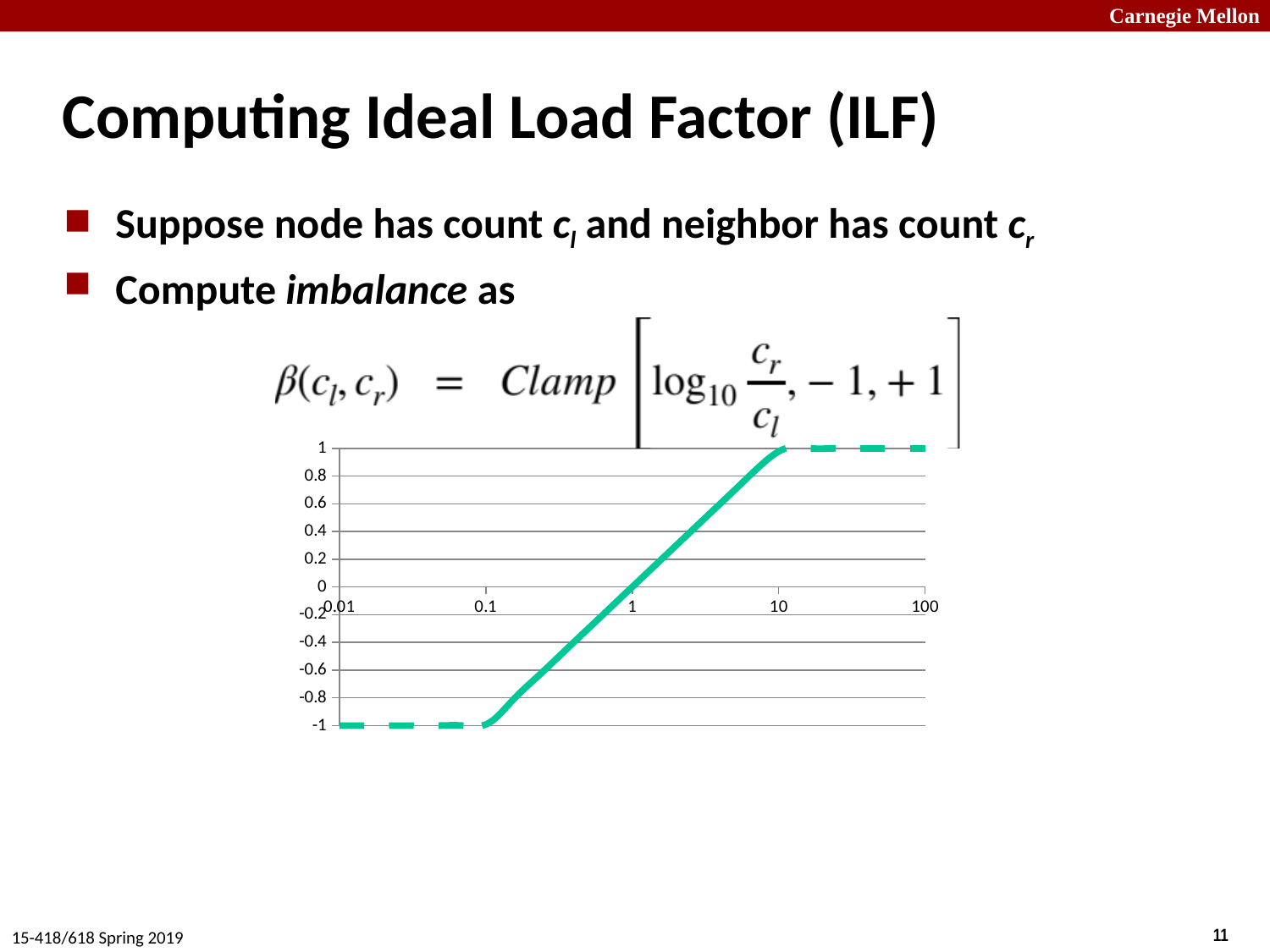
Is the value of the plotted line at x = 10 greater or less than 0.6? greater What is the value of the plotted line at x = 100? 1 What is the value of the plotted line at x = 0.1? -1 How many tick labels are shown on the x axis of the chart? 5 What is the lowest value reached by the plotted line? -1 What is the value of the plotted line at x = 0.01? -1 Is the value of the plotted line at x = 0.1 greater or less than 0? less Does the plotted line rise or fall as x increases from 0.1 to 10? rise What is the value of the plotted line at x = 1? 0 What kind of chart is shown on the slide? line chart What is the value of the plotted line at x = 10? 1 What is the highest value reached by the plotted line? 1